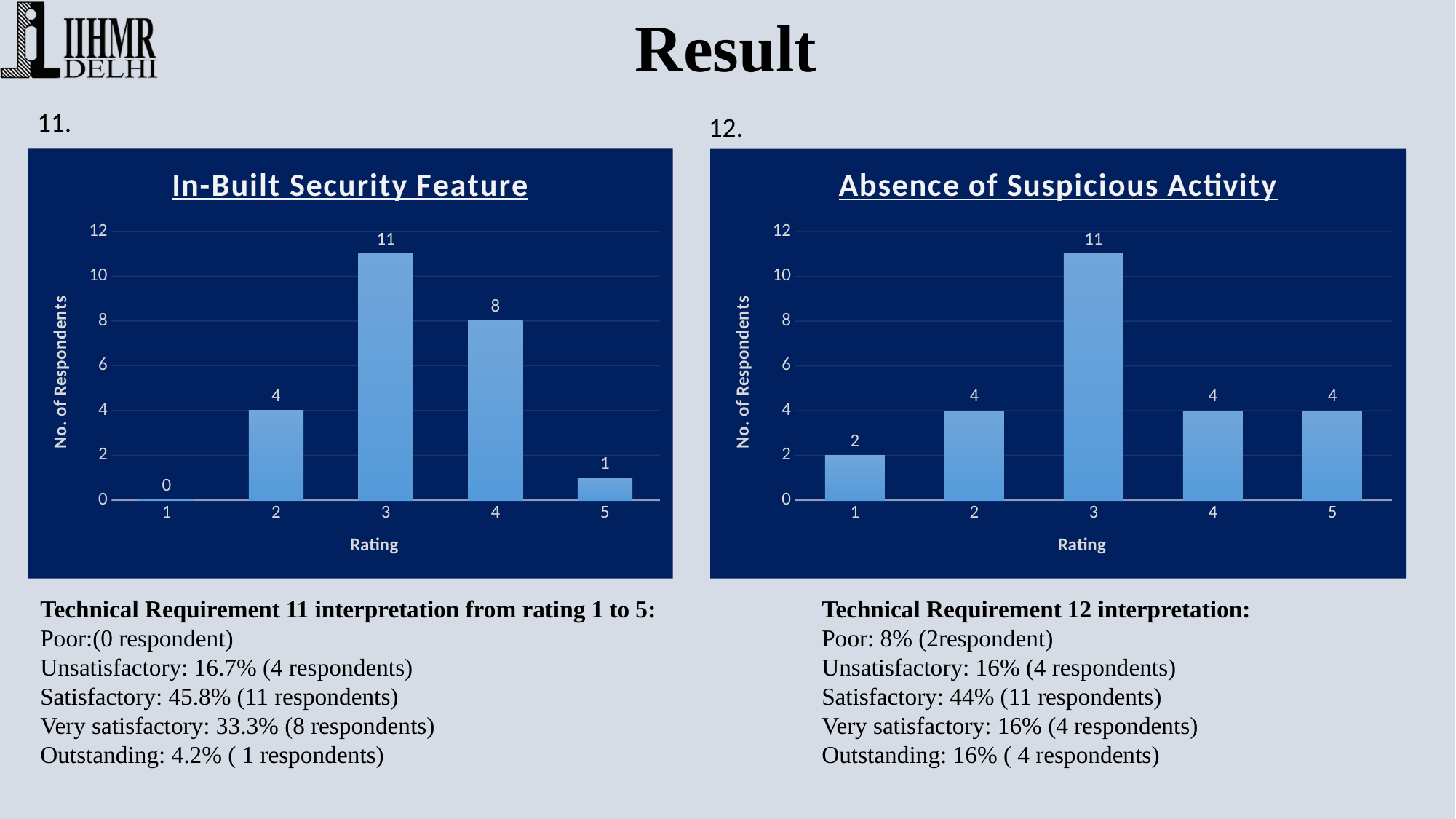
In the 'Absence of Suspicious Activity' chart, how many respondents gave a rating of 1? 2 In the 'In-Built Security Feature' chart, which rating has the lowest number of respondents? 1 In the 'In-Built Security Feature' chart, how many respondents gave a rating of 3? 11 In the 'Absence of Suspicious Activity' chart, which is larger: the value for rating 2 or the value for rating 1? Rating 2 How many rating categories are shown on the x axis of the 'In-Built Security Feature' chart? 5 In the 'Absence of Suspicious Activity' chart, which rating has the lowest number of respondents? 1 What type of chart is the 'Absence of Suspicious Activity' chart? Bar chart In the 'In-Built Security Feature' chart, what is the difference between the number of respondents for rating 3 and rating 4? 3 What is the y-axis label of the 'In-Built Security Feature' chart? No. of Respondents In the 'In-Built Security Feature' chart, how many respondents gave a rating of 5? 1 In the 'In-Built Security Feature' chart, which rating has the highest number of respondents? 3 In the 'Absence of Suspicious Activity' chart, how many respondents gave a rating of 3? 11